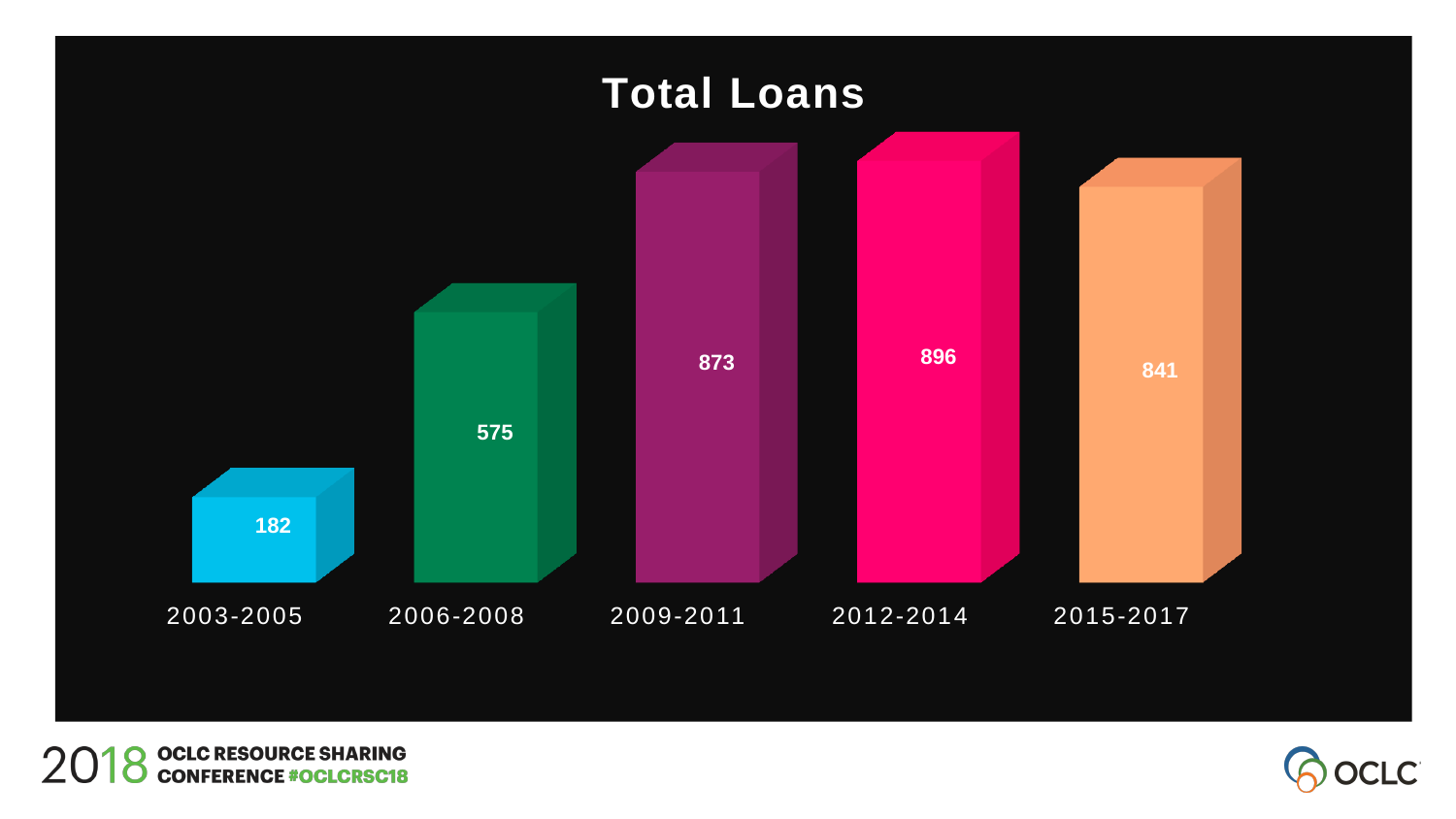
What is the title of the chart? Total Loans How many periods are shown on the chart? 5 Which period has the highest total loans? 2012-2014 What is the value for 2006-2008? 575 What kind of chart is this? bar chart What is the difference between the values for 2012-2014 and 2015-2017? 55 What is the value for 2003-2005? 182 What is the value for 2009-2011? 873 Which period has the lowest total loans? 2003-2005 Which is larger, the value for 2009-2011 or the value for 2015-2017? 2009-2011 What is the value for 2015-2017? 841 What is the difference between the values for 2006-2008 and 2003-2005? 393